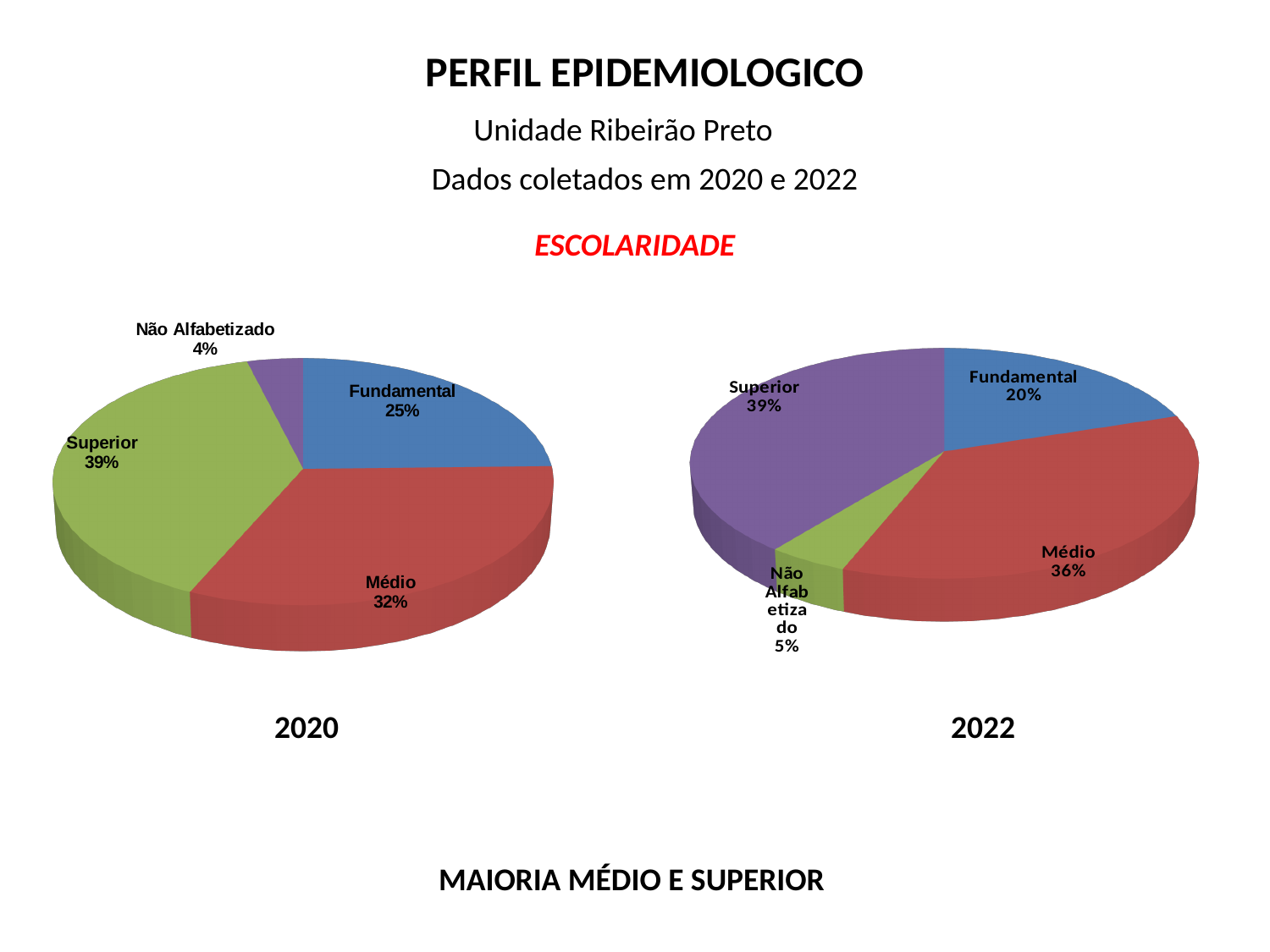
In the 2022 pie chart, what is the difference between the Médio and Fundamental shares? 16% In the 2022 pie chart, what share does Fundamental have? 20% What type of chart is used for the 2022 data? Pie chart In the 2022 pie chart, which category has the largest share? Superior How many categories does the 2020 pie chart show? 4 In the 2020 pie chart, what share does Superior have? 39% In the 2020 pie chart, what is the difference between the Superior and Fundamental shares? 14% In the 2022 pie chart, what colour is the Superior slice? Purple In the 2022 pie chart, what is the value for Não Alfabetizado? 5% In the 2022 pie chart, which is larger, Médio or Fundamental? Médio In the 2020 pie chart, which category has the smallest share? Não Alfabetizado In the 2020 pie chart, what is the value for Médio? 32%